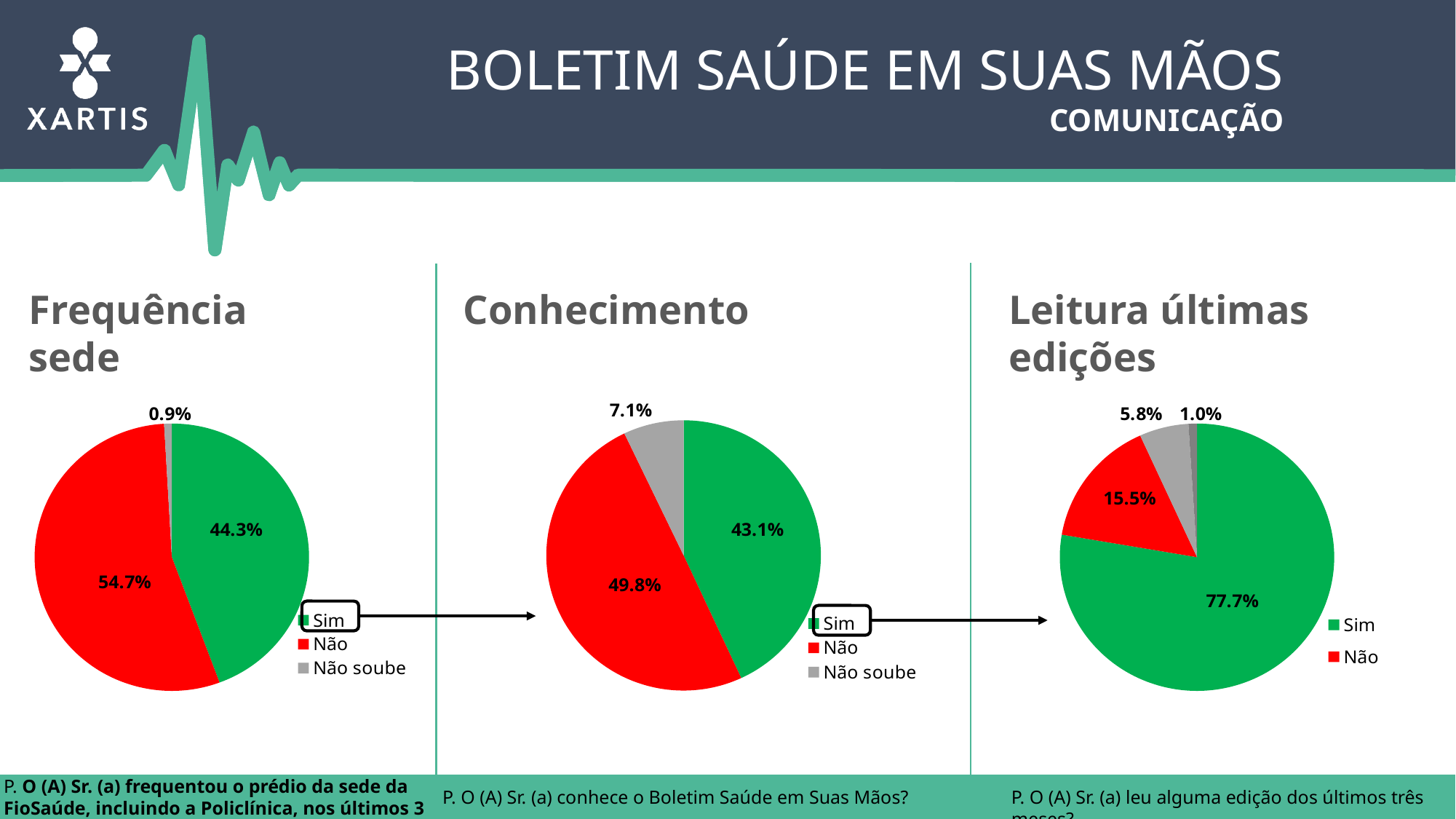
In the 'Frequência sede' chart, what percentage is shown for 'Não soube'? 0.9% In the 'Conhecimento' chart, what percentage is shown for 'Não soube'? 7.1% In the 'Frequência sede' chart, what percentage is shown for 'Não'? 54.7% How many entries does the legend of the 'Frequência sede' chart list? 3 In the 'Frequência sede' chart, what percentage is shown for 'Sim'? 44.3% In the 'Conhecimento' chart, which category has the largest share? Não In the 'Conhecimento' chart, which category has the smallest share? Não soube In the 'Frequência sede' chart, what is the difference between the 'Não' and 'Sim' percentages? 10.4% In the 'Leitura últimas edições' chart, what percentage is shown for 'Não'? 15.5% In the 'Leitura últimas edições' chart, what percentage is shown for 'Sim'? 77.7% What type of chart is used for 'Conhecimento'? Pie chart In the 'Conhecimento' chart, which is larger, 'Sim' or 'Não'? Não